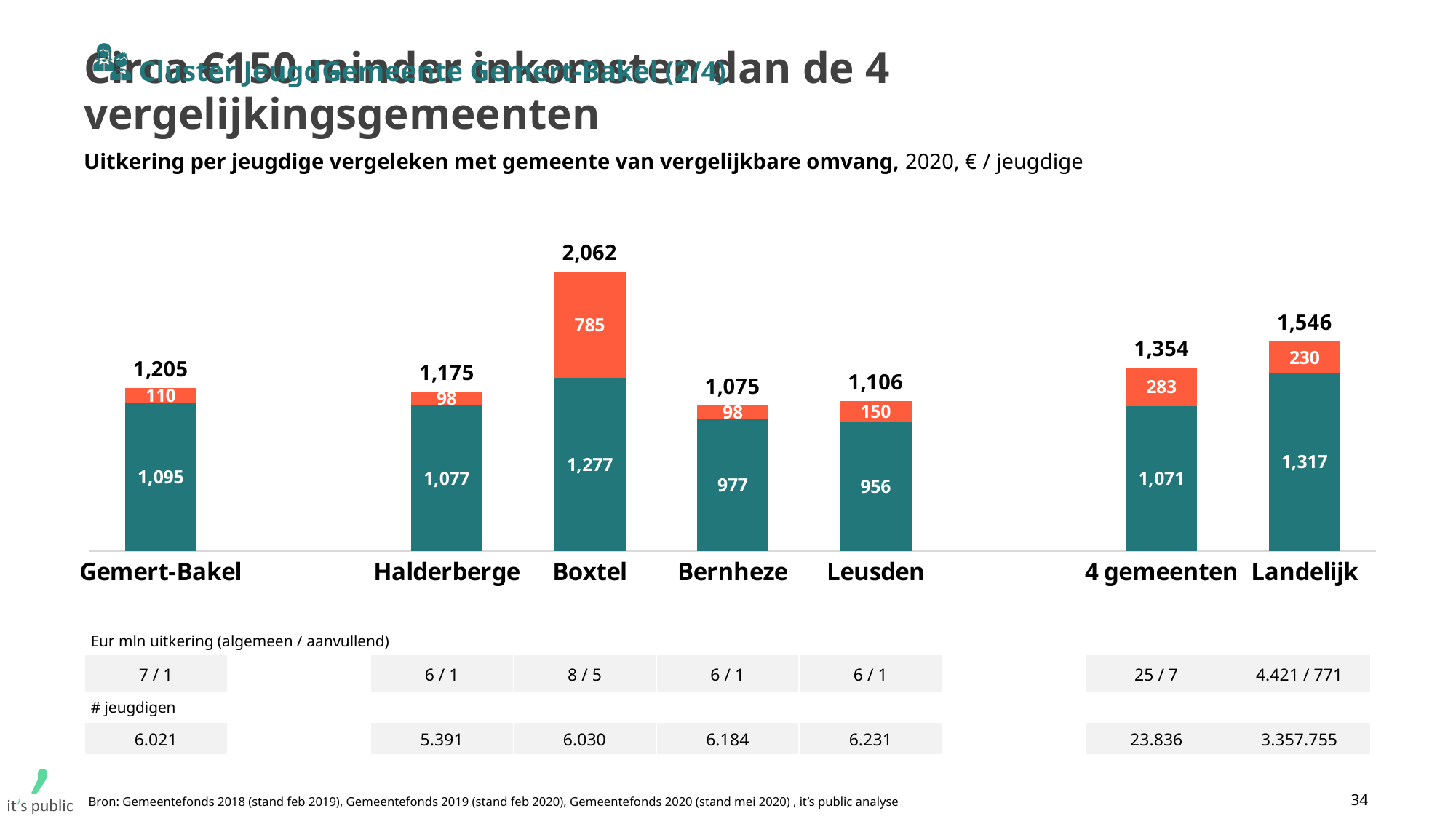
How many categories are shown on the x axis of the chart? 7 What is the total value shown above the bar for Boxtel? 2,062 Which category has the highest total value? Boxtel What is the difference between the total for Landelijk and the total for 4 gemeenten? 192 What is the sum of the two segments of the 4 gemeenten bar? 1,354 What is the difference between the total for Boxtel and the total for Gemert-Bakel? 857 What kind of chart is shown on the slide? Stacked bar chart What is the value of the top (orange) segment of the Leusden bar? 150 Which category has the lowest total value? Bernheze What is the value of the bottom (teal) segment of the Gemert-Bakel bar? 1,095 What is the total value shown above the bar for Landelijk? 1,546 Which has a larger total value, Gemert-Bakel or Halderberge? Gemert-Bakel